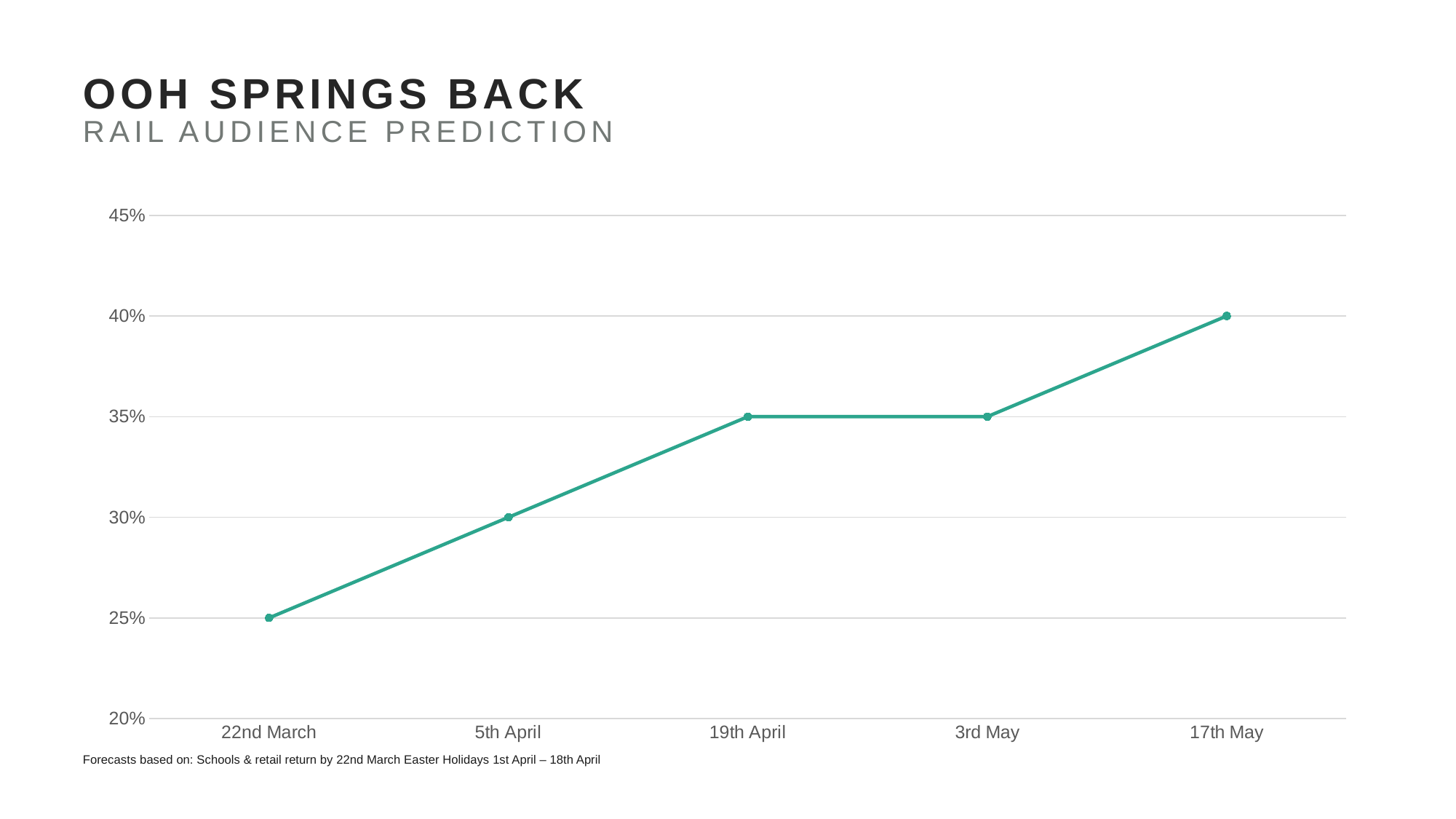
Which date has the highest predicted rail audience value? 17th May How many dates are plotted on the x axis? 5 What is the difference between the values for 17th May and 22nd March? 15% What kind of chart is shown on the slide? line chart What is the subtitle of the chart on the slide? RAIL AUDIENCE PREDICTION Which date has the lowest predicted rail audience value? 22nd March What is the predicted rail audience value for 5th April? 30% What is the predicted rail audience value for 17th May? 40% Do the values generally rise or fall from 22nd March to 17th May? rise What is the predicted rail audience value for 19th April? 35% What is the predicted rail audience value for 22nd March? 25% Which is larger, the value for 5th April or the value for 3rd May? 3rd May